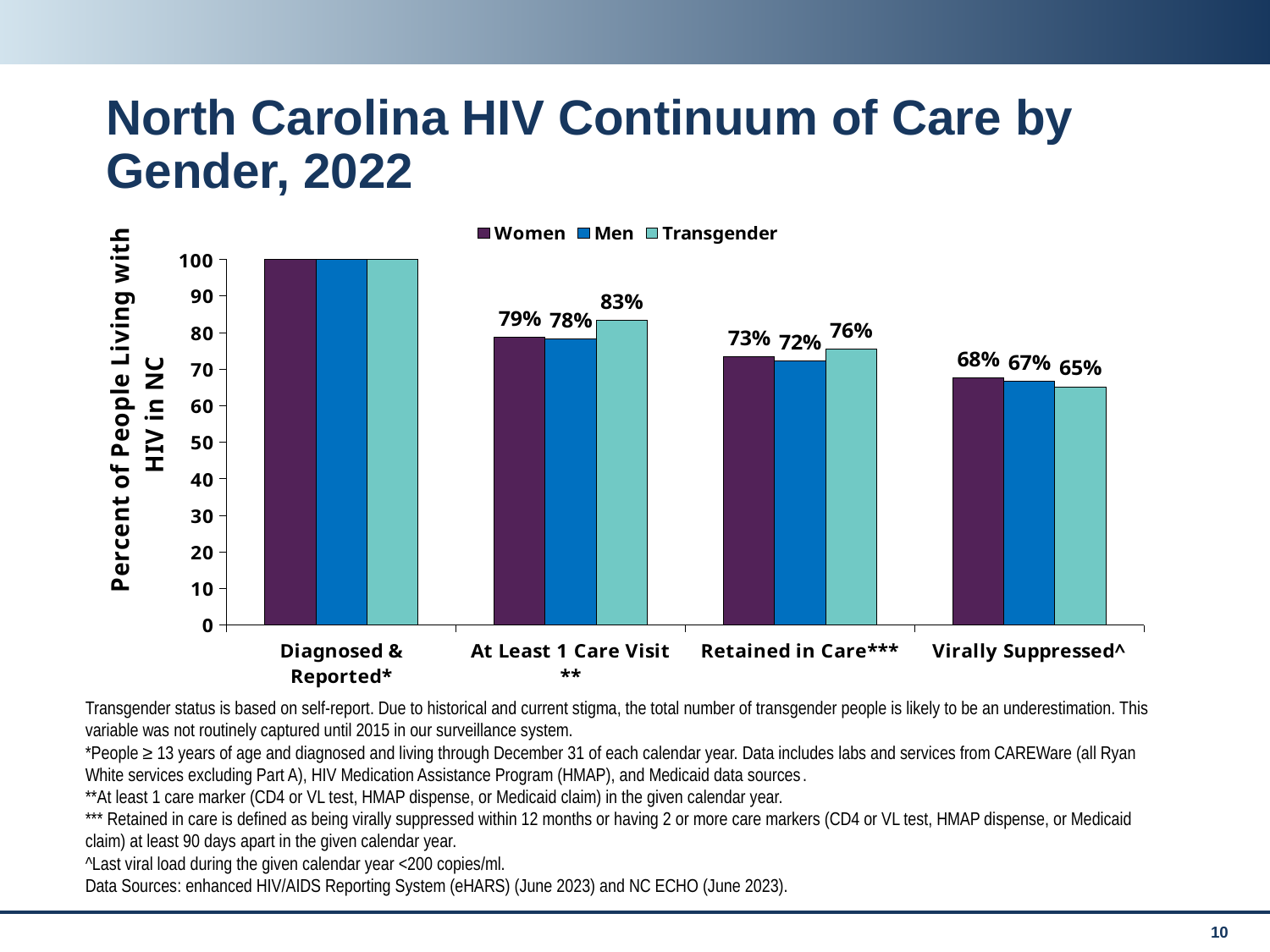
What is the y-axis title of the chart? Percent of People Living with HIV in NC Do the values for Women rise or fall from left to right across the categories? fall How many categories are shown along the x axis? 4 What is the value for Women in the Retained in Care category? 73% Is the value for Women in the Virally Suppressed category greater or less than 70? less What type of chart is shown on the slide? bar chart Which series has the highest value in the Retained in Care category? Transgender What is the value for Men in the Virally Suppressed category? 67% What is the difference between the Transgender and Men values in the At Least 1 Care Visit category? 5% How many series does the legend list? 3 What is the value for Transgender in the At Least 1 Care Visit category? 83% Which series has the lowest value in the Virally Suppressed category? Transgender